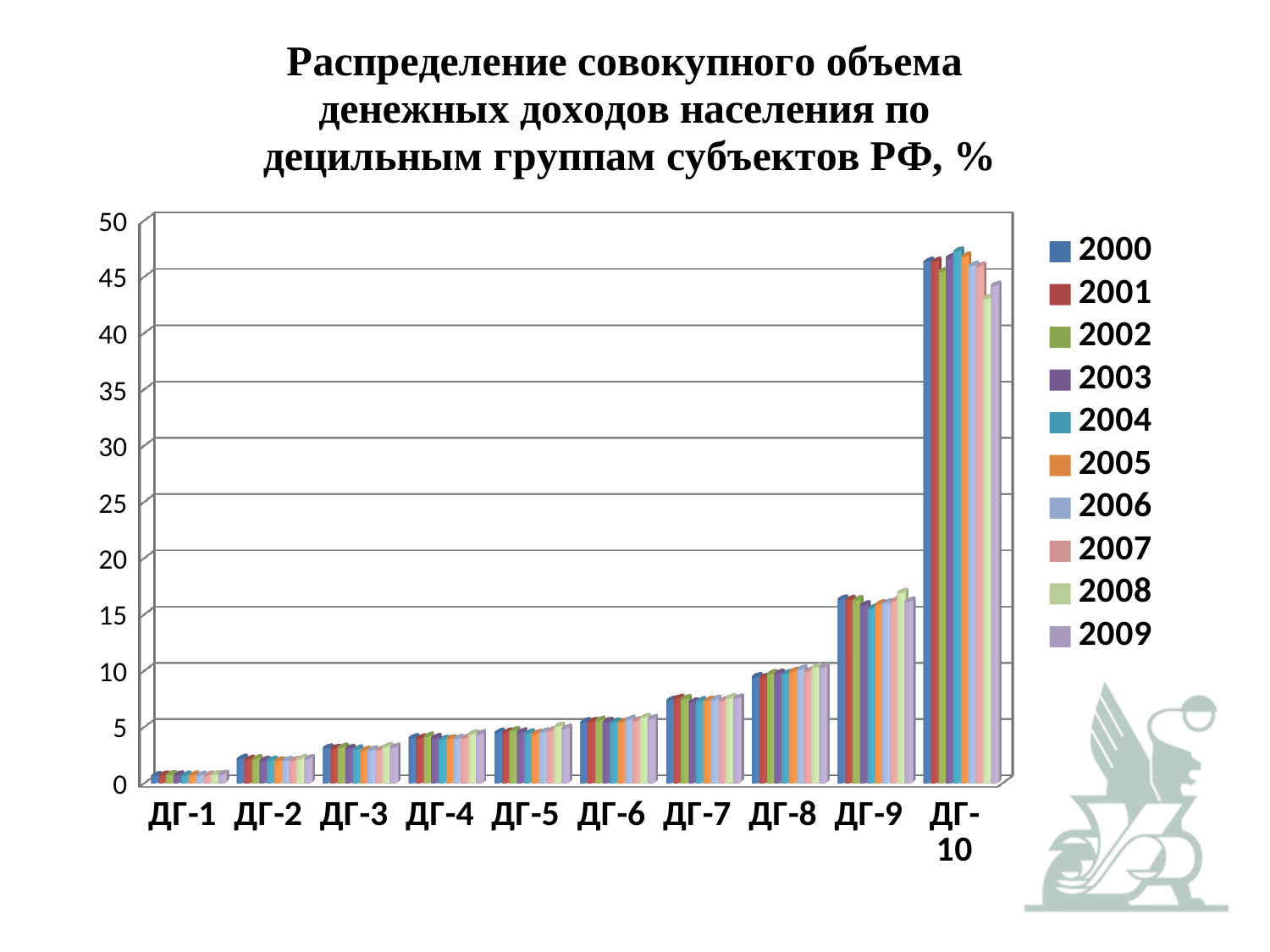
Is the value for ДГ-1 in 2005 greater or less than 5? less Which decile group has the highest share of total money income? ДГ-10 Is the value for ДГ-9 in 2008 greater or less than 10? greater How many decile groups (categories) are shown on the x axis? 10 What kind of chart is shown on the slide? bar chart Which has the larger value in 2009: ДГ-2 or ДГ-8? ДГ-8 Which decile group has the lowest share of total money income? ДГ-1 Do the values rise or fall moving from ДГ-1 to ДГ-10 along the x axis? rise How many series (years) does the legend list? 10 Which years are the first and last entries in the legend? 2000 and 2009 Is the value for ДГ-8 in 2009 greater or less than 15? less